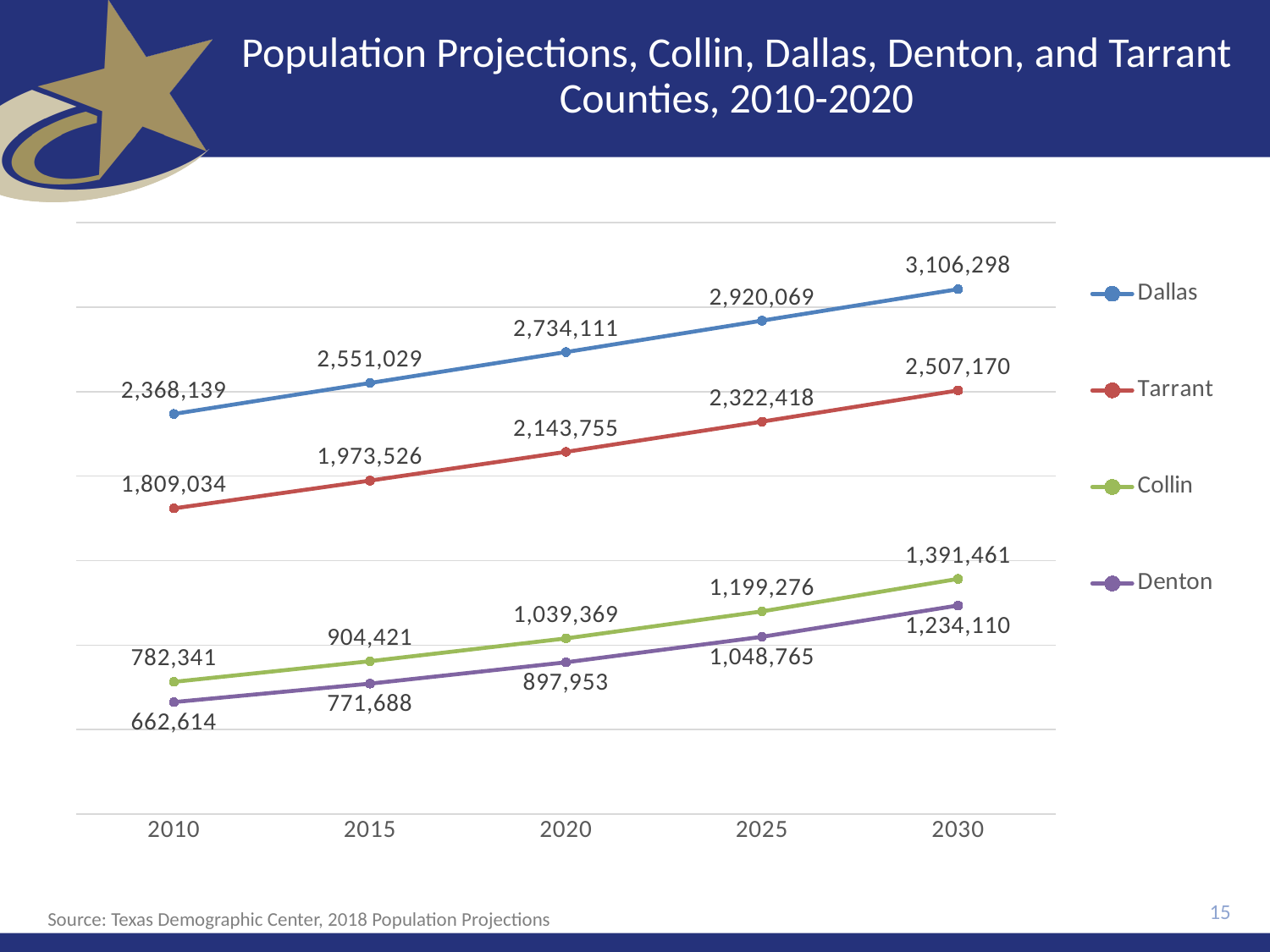
What kind of chart is shown on the slide? Line chart How many years are shown on the x axis? 5 Which is larger in 2025, the Collin County projection or the Denton County projection? Collin What is the projected population of Dallas County in 2030? 3,106,298 What is the projected population of Collin County in 2015? 904,421 What is the difference between the 2030 projections for Dallas and Tarrant counties? 599,128 What is the projected population of Denton County in 2010? 662,614 How many series does the legend list? 4 Which county has the highest projected population in 2030? Dallas What is the projected population of Tarrant County in 2020? 2,143,755 By how much does the Dallas County projection increase from 2010 to 2030? 738,159 Which county has the lowest projected population in 2010? Denton